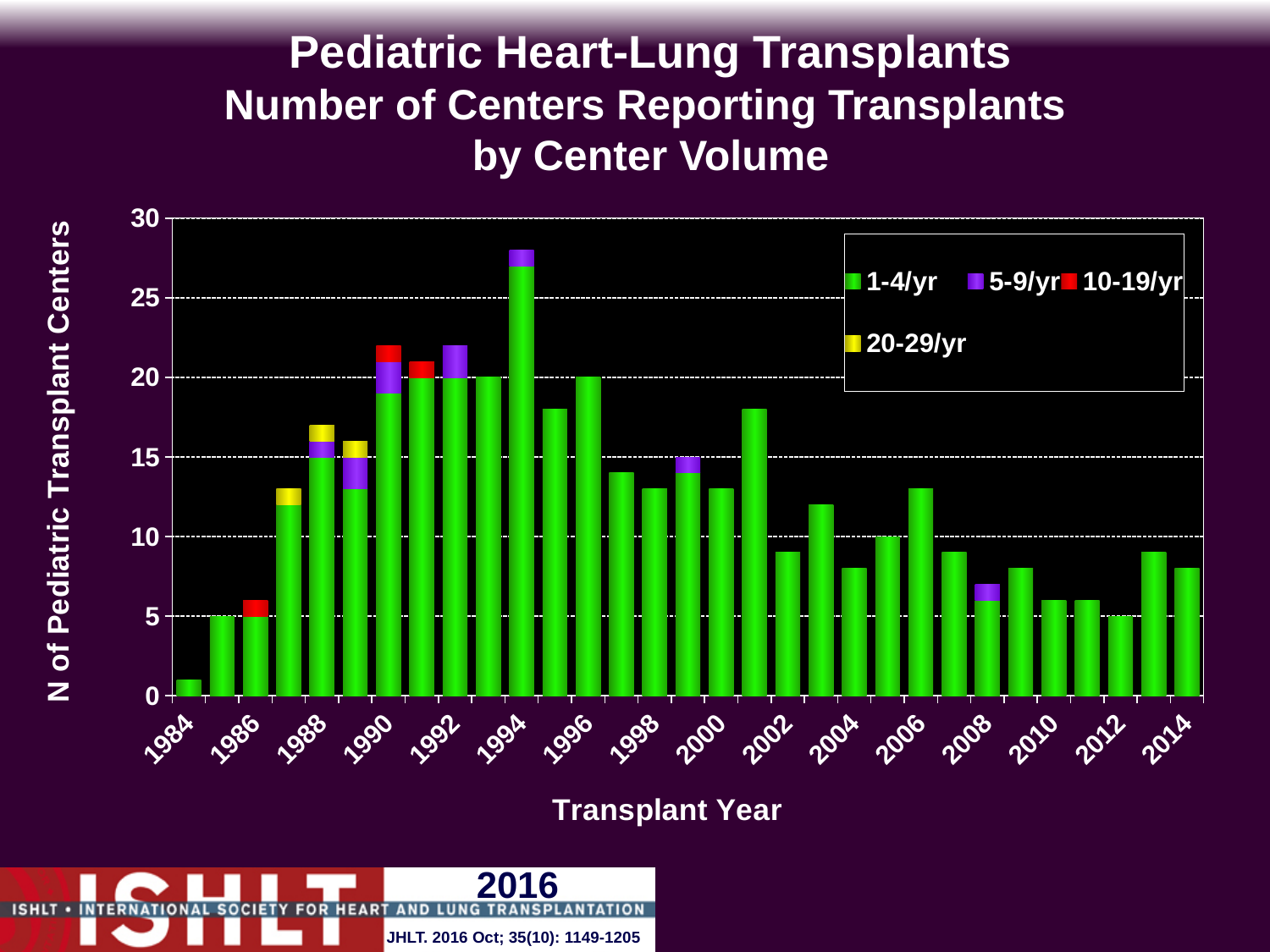
Which transplant year has the highest total number of pediatric transplant centers? 1994 Is the total number of centers for 1994 greater or less than 25? greater Which year has more reporting centers in total, 1988 or 2008? 1988 Is the total number of centers for 2010 greater or less than 10? less Which year has more reporting centers in total, 1994 or 2002? 1994 Is the total number of centers for 1984 greater or less than 5? less Which colour represents the 10-19/yr center volume category in the legend? Red Do the total numbers of centers generally rise or fall from 2002 to 2012? fall How many series does the legend list? 4 Which transplant year has the lowest total number of pediatric transplant centers? 1984 What kind of chart is shown on the slide? Stacked bar chart